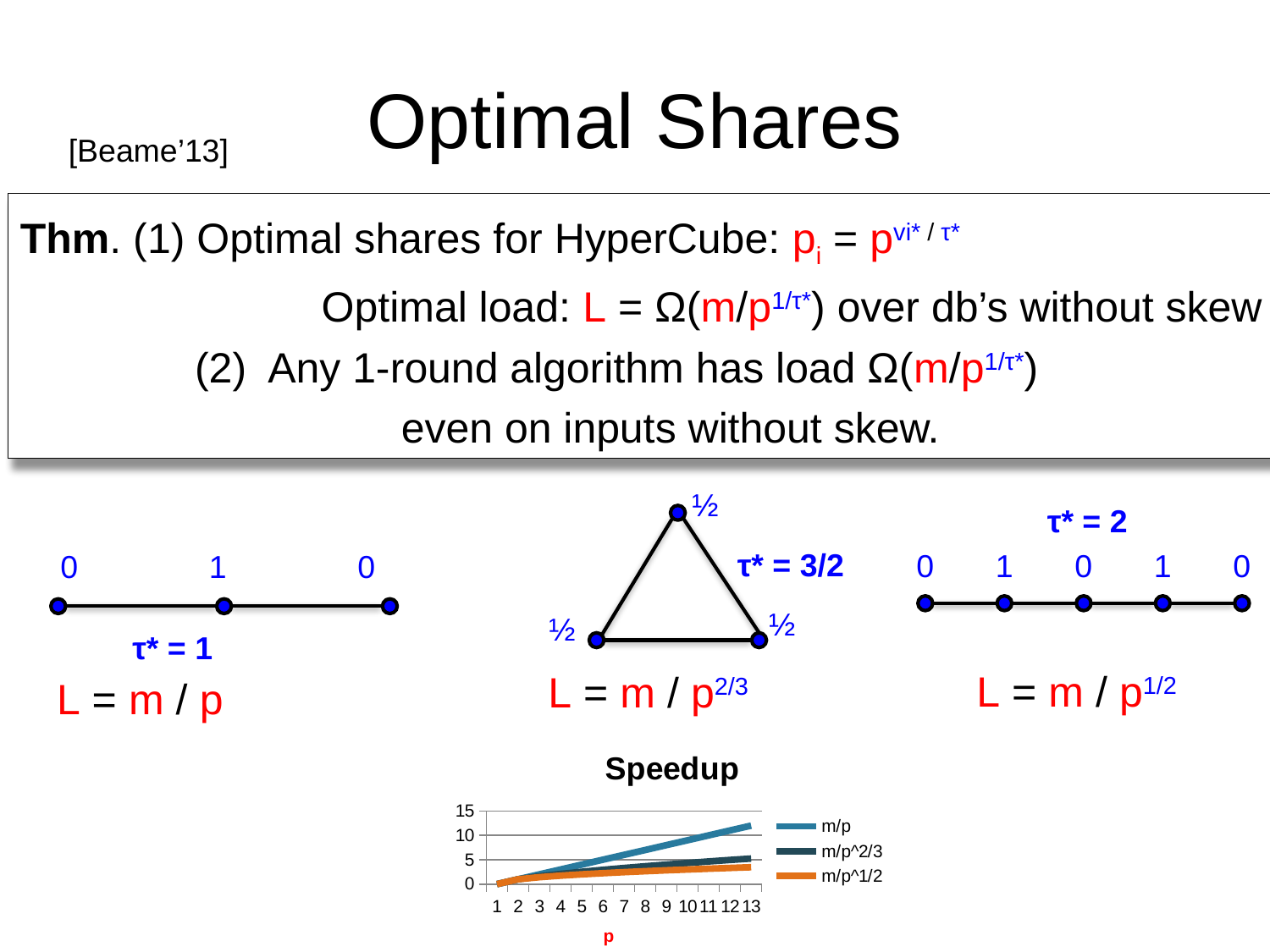
In the "Speedup" chart, at p = 13, is the value of m/p^2/3 greater or less than 10? less In the "Speedup" chart, at p = 13, is the value of m/p^1/2 greater or less than 5? less What is the label of the x axis of the "Speedup" chart? p How many values of p are shown on the x axis of the "Speedup" chart? 13 In the "Speedup" chart, does the m/p series rise or fall as p increases? rise In the "Speedup" chart, which series has the highest value at p = 13? m/p In the "Speedup" chart, at p = 13, which is larger: the value of m/p or the value of m/p^2/3? m/p What kind of chart is the "Speedup" chart? line chart In the "Speedup" chart, at p = 13, is the value of m/p greater or less than 10? greater What are the three series named in the legend of the "Speedup" chart? m/p, m/p^2/3, m/p^1/2 In the "Speedup" chart, which series has the lowest value at p = 13? m/p^1/2 How many series does the legend of the "Speedup" chart list? 3